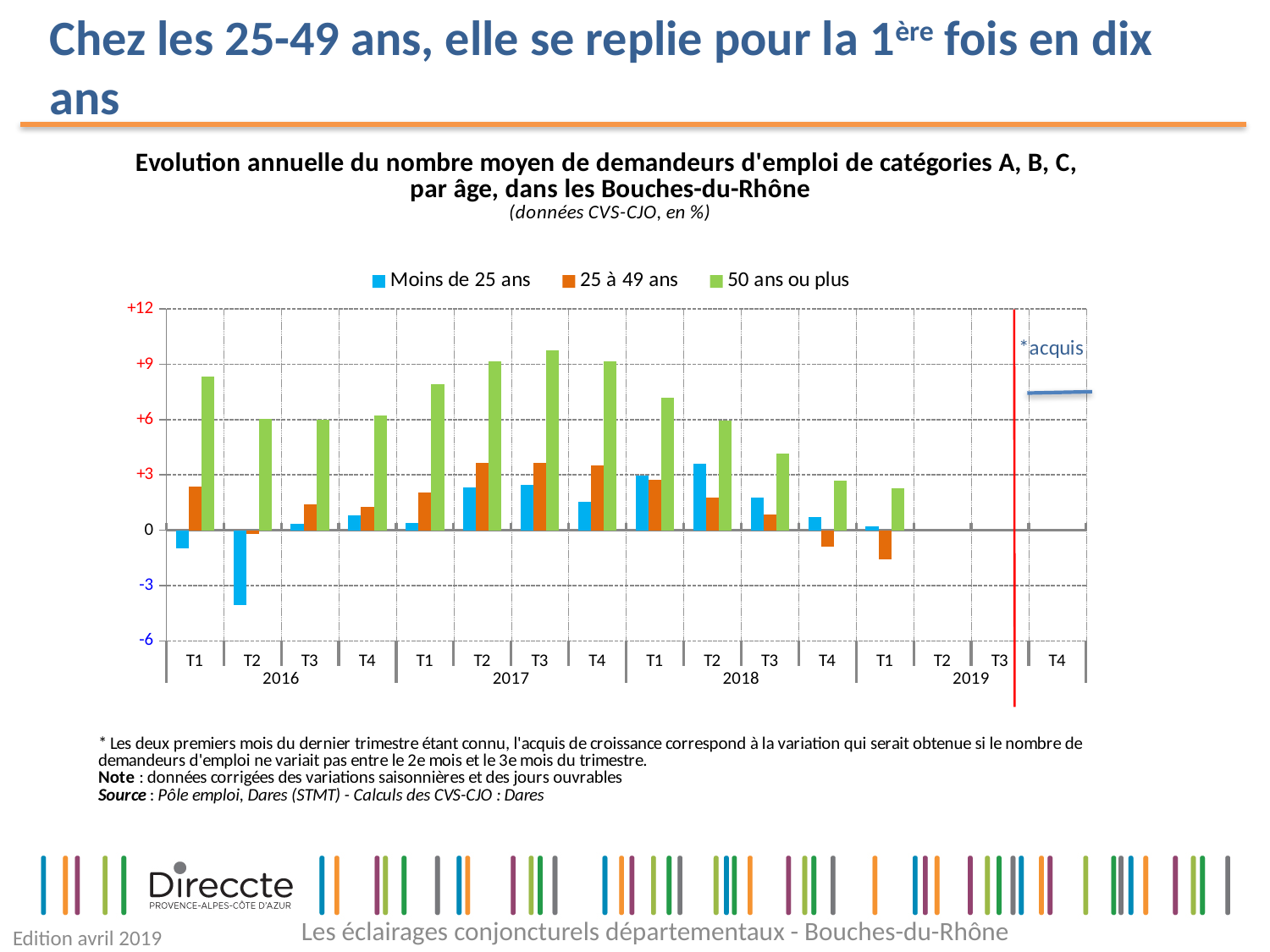
From T3 2017 to T1 2019, do the values for '50 ans ou plus' rise or fall? fall Which series is shown in orange in the legend? 25 à 49 ans In T2 2018, which is larger: the value for 'Moins de 25 ans' or for '25 à 49 ans'? Moins de 25 ans Is the value for '50 ans ou plus' in T3 2017 greater or less than +9? greater In which quarter does the 'Moins de 25 ans' series reach its lowest value? T2 2016 What type of chart is shown on the slide? bar chart In T1 2016, which is larger: the value for '50 ans ou plus' or for '25 à 49 ans'? 50 ans ou plus In which quarter does the '50 ans ou plus' series reach its highest value? T3 2017 How many years are labelled on the x axis? 4 Is the value for '25 à 49 ans' in T1 2019 greater or less than 0? less How many series does the legend list? 3 Is the value for 'Moins de 25 ans' in T2 2016 greater or less than -3? less